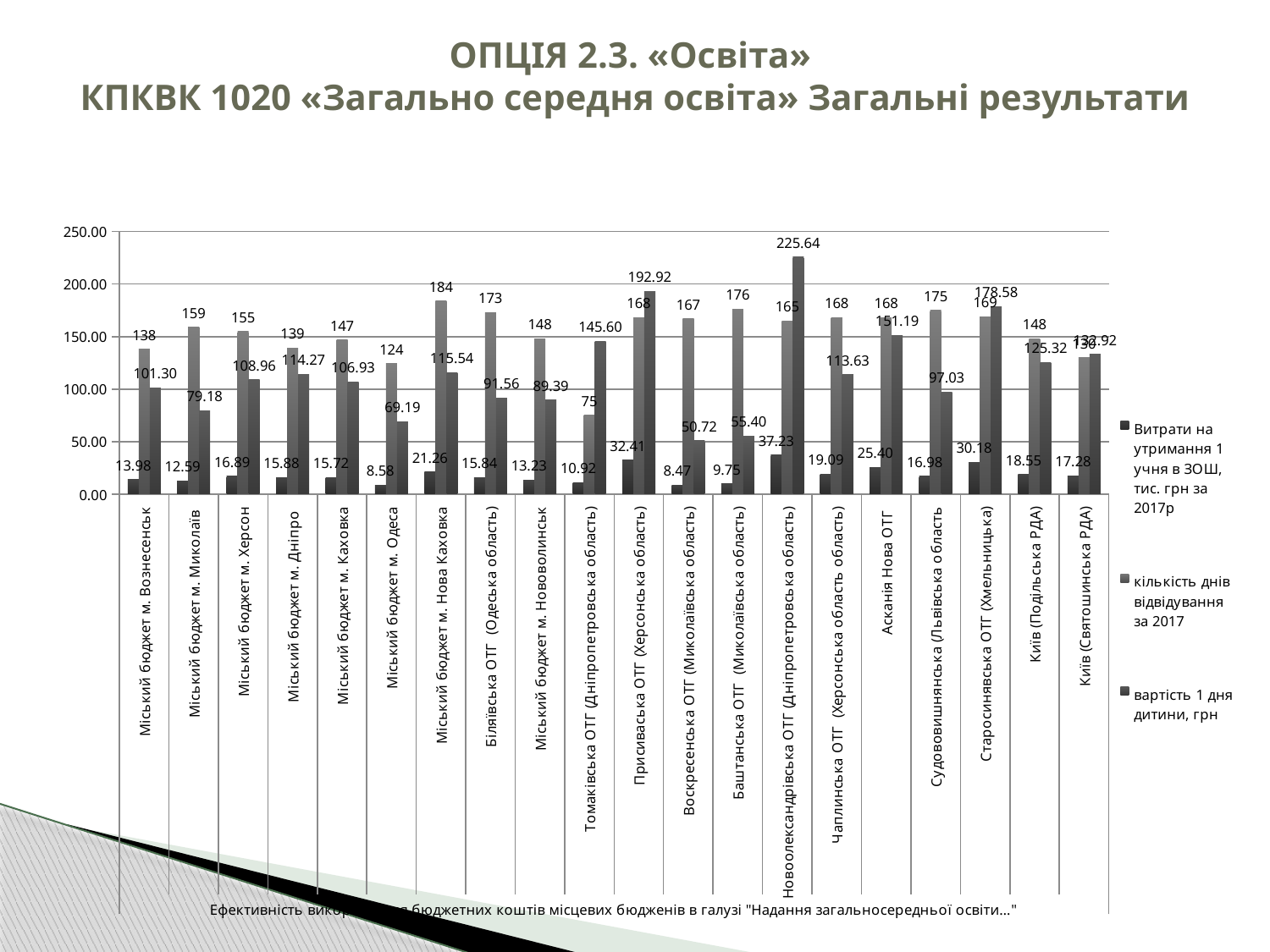
Which category has the lowest 'Витрати на утримання 1 учня в ЗОШ'? Воскресенська ОТГ (Миколаївська область) What is the 'кількість днів відвідування за 2017' for Міський бюджет м. Нова Каховка? 184 Which category has the lowest 'кількість днів відвідування за 2017'? Томаківська ОТГ (Дніпропетровська область) What kind of chart is shown on the slide? bar chart Which has more 'кількість днів відвідування за 2017': Біляївська ОТГ (Одеська область) or Міський бюджет м. Нововолинськ? Біляївська ОТГ (Одеська область) Which category has the highest 'вартість 1 дня дитини, грн'? Новоолександрівська ОТГ (Дніпропетровська область) What is the difference in 'вартість 1 дня дитини, грн' between Присиваська ОТГ (Херсонська область) and Чаплинська ОТГ (Херсонська область)? 79.29 How many series does the legend list? 3 How many categories (budgets/ОТГ) are shown on the x axis? 20 What is the value of 'Витрати на утримання 1 учня в ЗОШ, тис. грн за 2017р' for Новоолександрівська ОТГ (Дніпропетровська область)? 37.23 What is the difference in 'кількість днів відвідування за 2017' between Міський бюджет м. Нова Каховка and Міський бюджет м. Одеса? 60 What is the 'вартість 1 дня дитини, грн' for Міський бюджет м. Одеса? 69.19